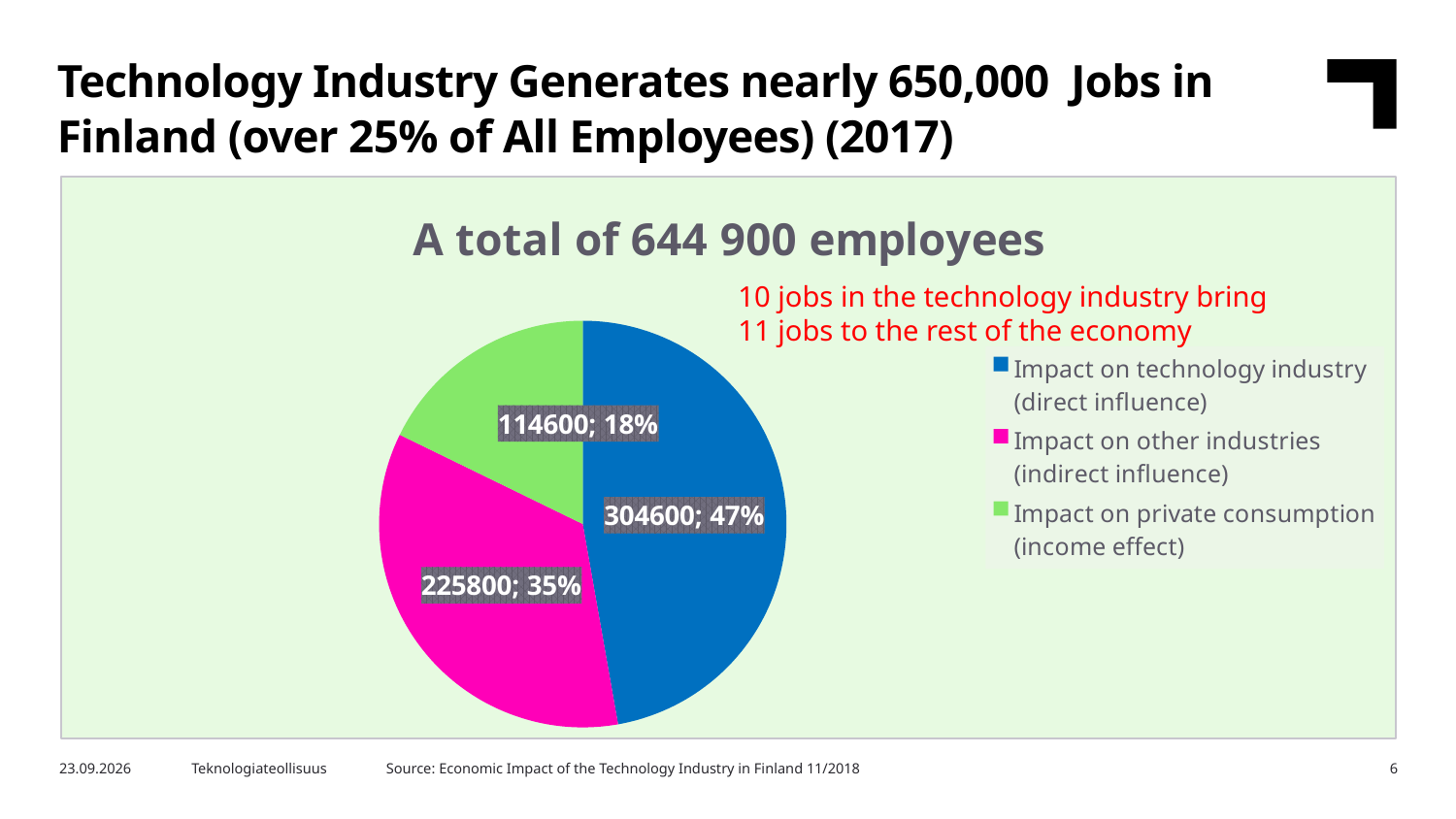
What is the difference between the values for 'Impact on technology industry (direct influence)' and 'Impact on other industries (indirect influence)'? 78800 Which category has the largest slice? Impact on technology industry (direct influence) What is the value for 'Impact on technology industry (direct influence)'? 304600 What is the value for 'Impact on private consumption (income effect)'? 114600 What share of the pie does 'Impact on technology industry (direct influence)' represent? 47% How many entries does the legend list? 3 What share of the pie does 'Impact on private consumption (income effect)' represent? 18% What kind of chart is shown on the slide? Pie chart What is the title of the chart? A total of 644 900 employees Which category has the smallest slice? Impact on private consumption (income effect) What is the value for 'Impact on other industries (indirect influence)'? 225800 How many slices does the pie chart have? 3